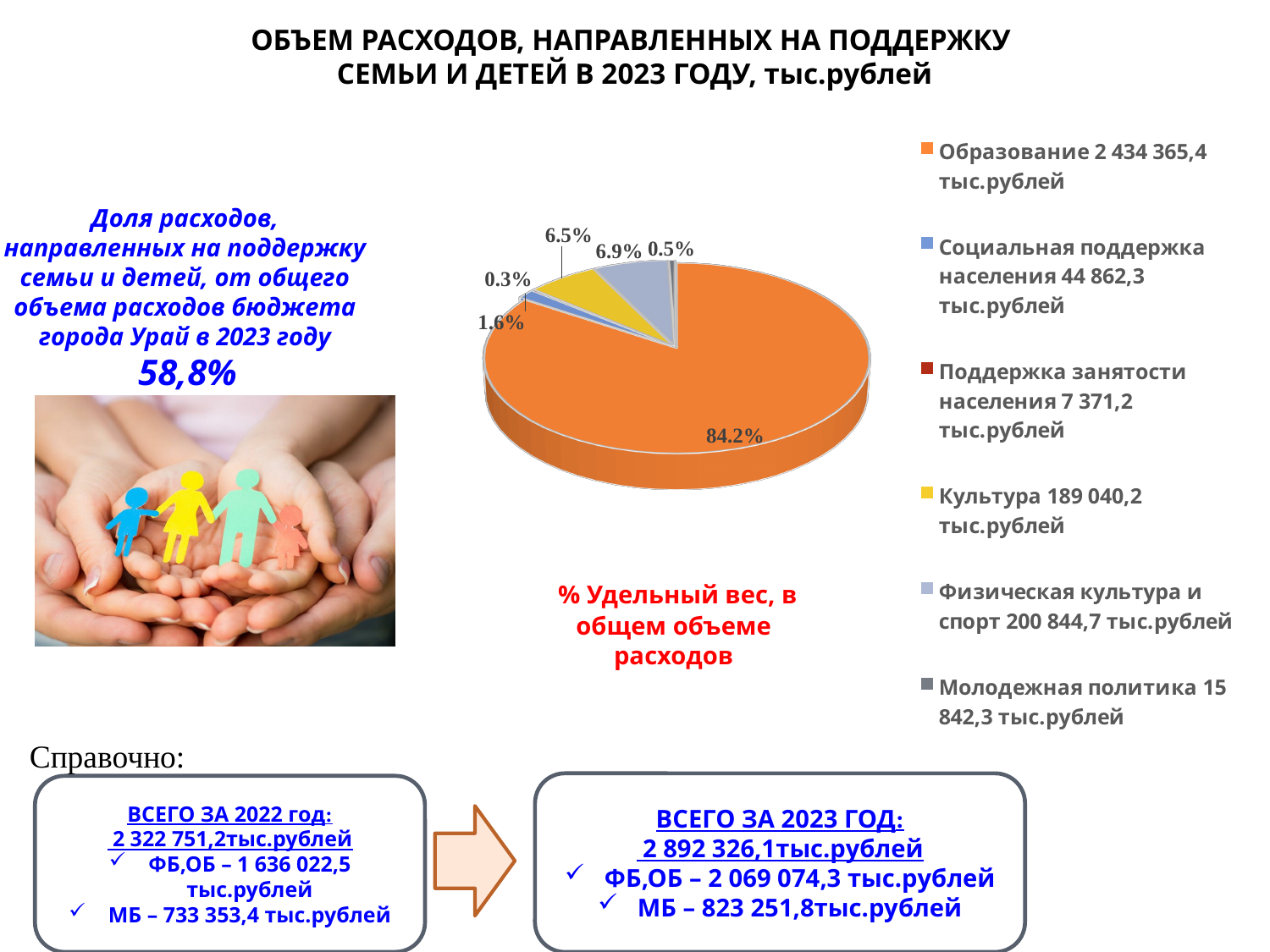
What is the difference in percentage points between the share of Образование and the share of Физическая культура и спорт? 77.3 What share of the pie chart does Образование have? 84.2% Which has the larger share of the pie chart, Культура or Физическая культура и спорт? Физическая культура и спорт Which category has the smallest share of the pie chart? Поддержка занятости населения Which category has the largest share of the pie chart? Образование What share of the pie chart does Физическая культура и спорт have? 6.9% What amount in тыс.рублей does the legend give for Поддержка занятости населения? 7 371,2 тыс.рублей What amount in тыс.рублей does the legend give for Молодежная политика? 15 842,3 тыс.рублей How many categories does the legend of the pie chart list? 6 What kind of chart is shown on the slide? pie chart What share of the pie chart does Социальная поддержка населения have? 1.6%